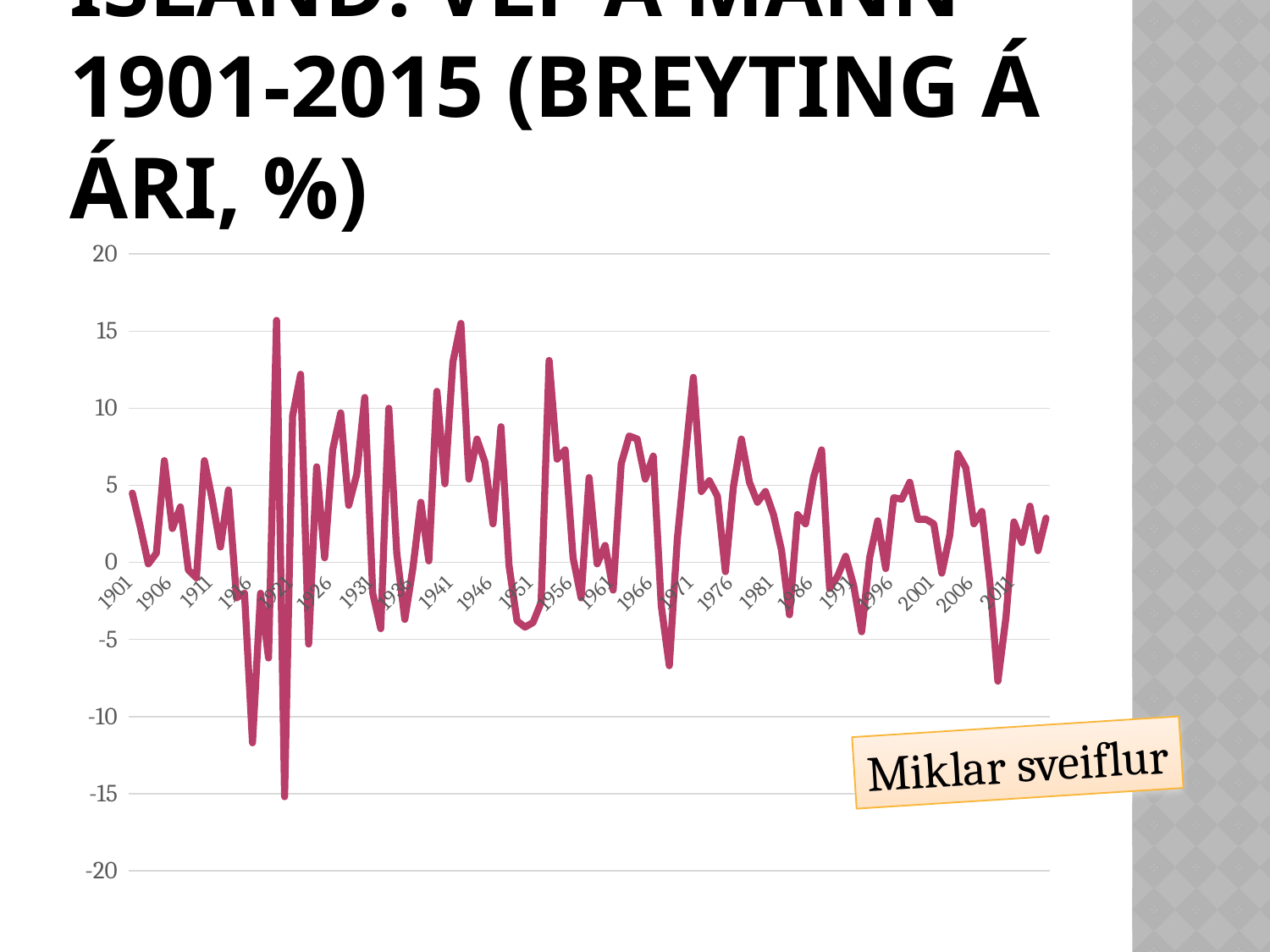
Is the value for 1901 greater or less than 0? greater Does the line stay above 0 for the entire period? No How many lines (data series) are plotted on the chart? 1 What kind of chart is shown on the slide? line chart What is the first year label on the horizontal axis? 1901 Is the sharp dip around 2009 greater or less than -5? less Is the highest point of the line greater or less than 10? greater How many year labels are shown along the horizontal axis? 23 What is the lowest value shown on the vertical axis? -20 What is the highest value shown on the vertical axis? 20